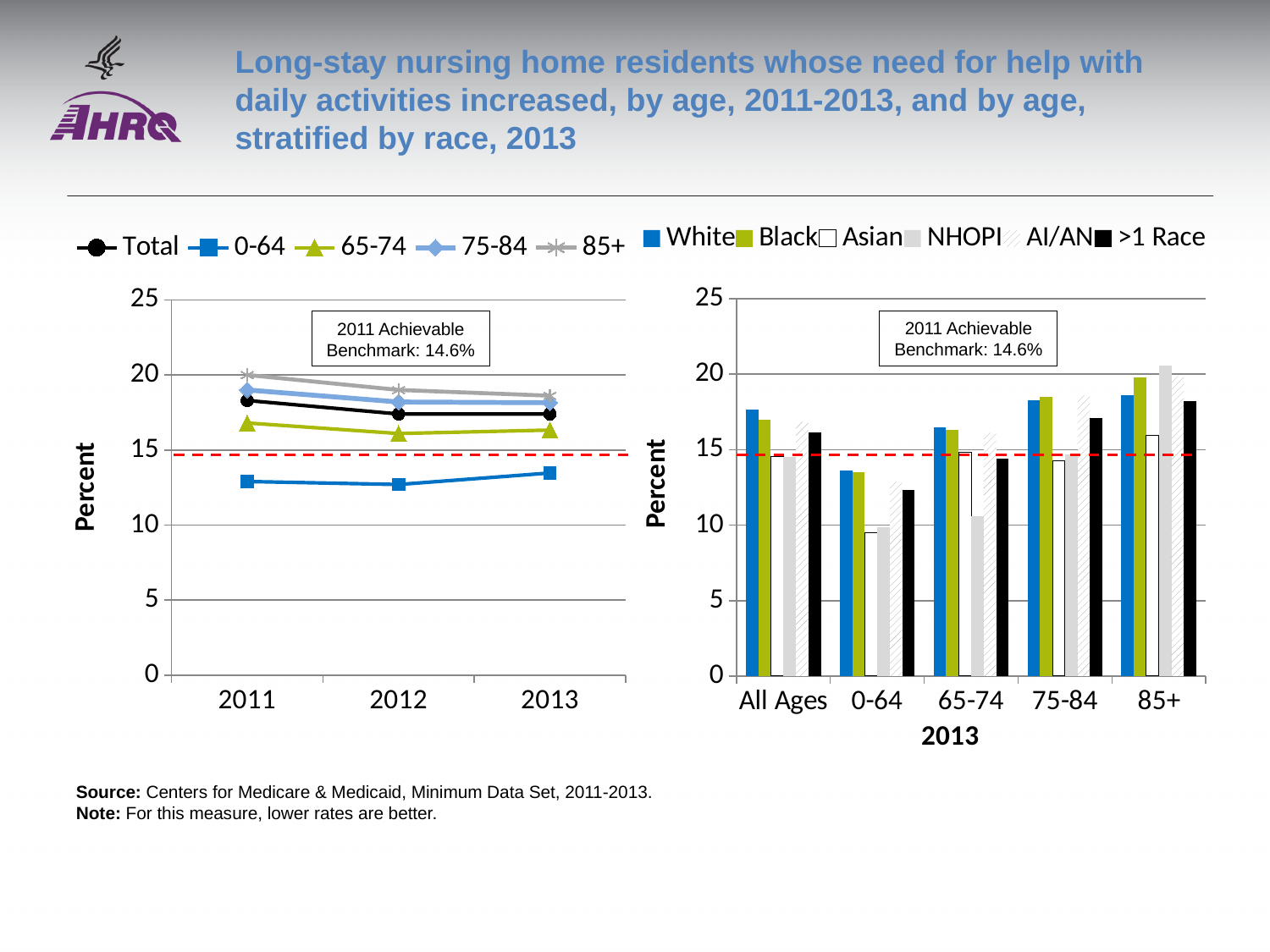
In the left chart, which age group has the lowest values across all years? 0-64 What type of chart is the right chart showing data by age stratified by race for 2013? bar chart In the left chart, how many series does the legend list? 5 In the left chart, which age group has the highest values across all years? 85+ In the left chart, is the value for 0-64 in 2011 greater or less than 15? less In the right chart, is the value for Asian in the 0-64 group greater or less than 10? less In the right chart, how many age categories are shown on the x axis? 5 What type of chart is the left chart showing data by age for 2011-2013? line chart In the right chart, which race has the highest value in the 85+ group? NHOPI What is the 2011 Achievable Benchmark shown on the charts? 14.6% In the left chart, does the 85+ line rise or fall from 2011 to 2013? fall In the right chart, how many series does the legend list? 6